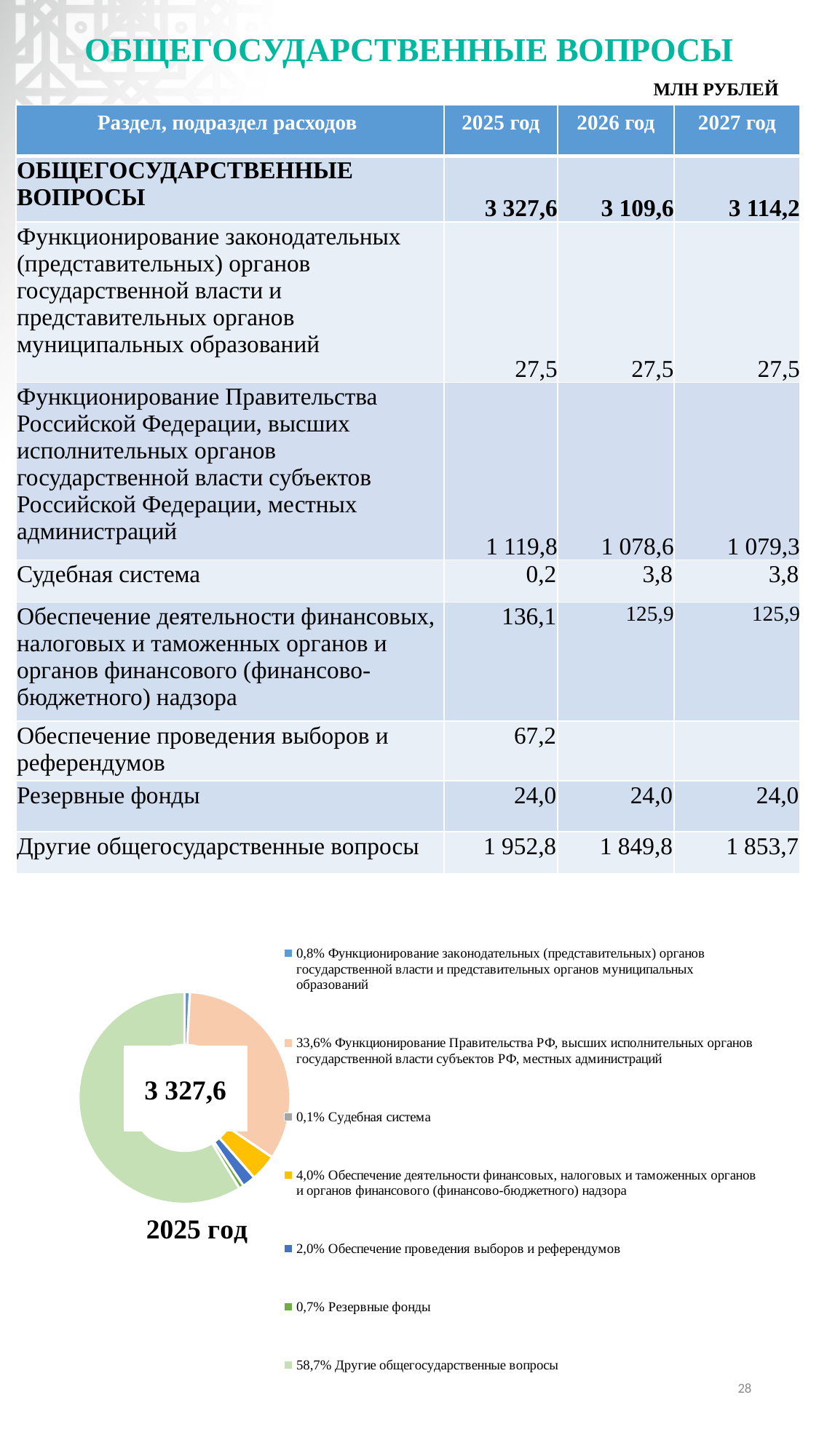
In the doughnut chart, what share is shown for "Другие общегосударственные вопросы"? 58,7% Which year does the doughnut chart represent? 2025 год Which category has the largest share in the doughnut chart? Другие общегосударственные вопросы In the doughnut chart, what share is shown for "Резервные фонды"? 0,7% What total value is printed in the centre of the doughnut chart? 3 327,6 In the doughnut chart, what share is shown for "Функционирование Правительства РФ, высших исполнительных органов государственной власти субъектов РФ, местных администраций"? 33,6% In the doughnut chart, which share is larger: "Обеспечение деятельности финансовых, налоговых и таможенных органов и органов финансового (финансово-бюджетного) надзора" or "Обеспечение проведения выборов и референдумов"? Обеспечение деятельности финансовых, налоговых и таможенных органов и органов финансового (финансово-бюджетного) надзора How many categories does the doughnut chart's legend list? 7 What kind of chart is shown at the bottom of the slide? Doughnut (pie) chart Which category has the smallest share in the doughnut chart? Судебная система